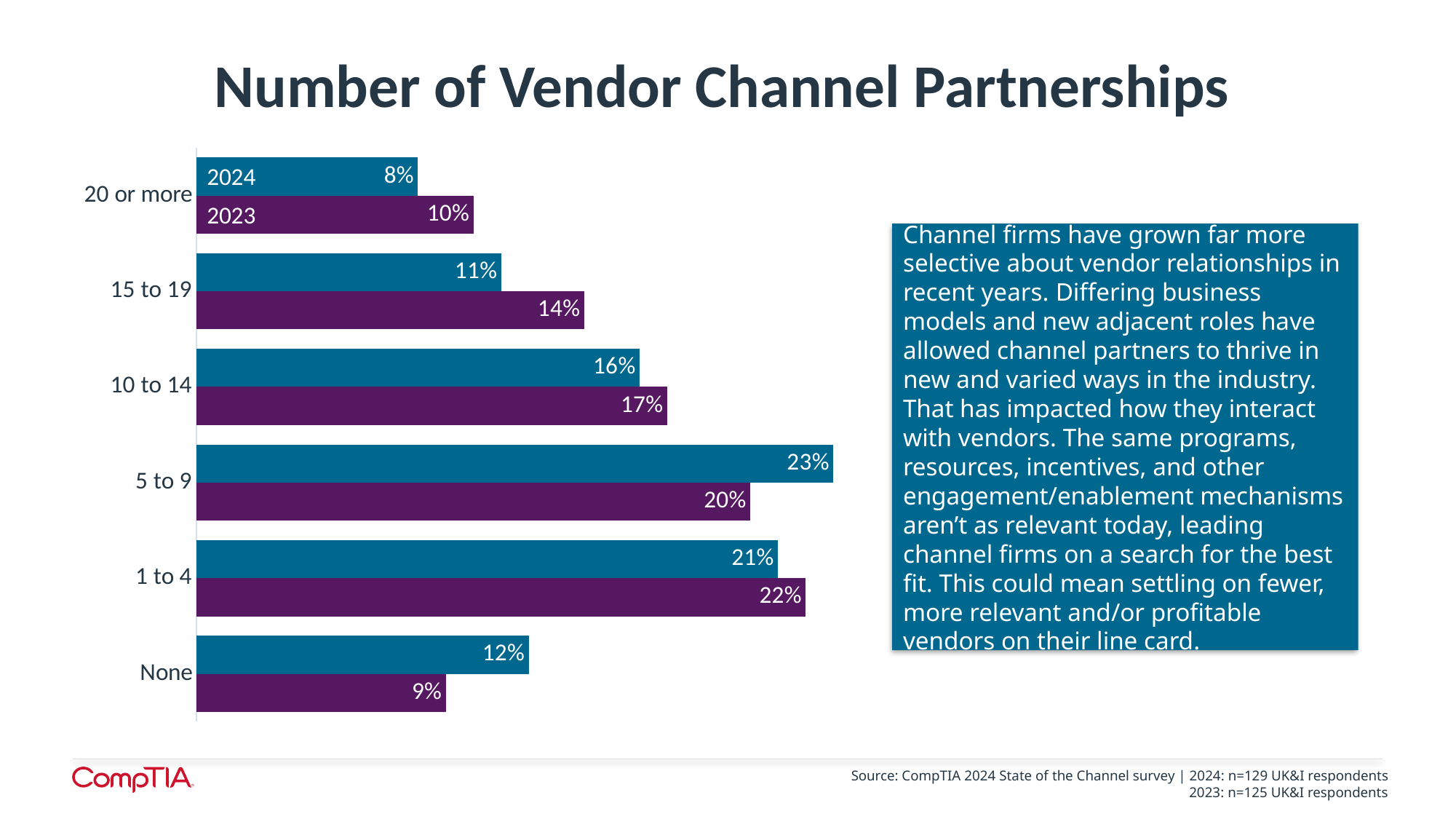
Which category has the lowest 2024 value? 20 or more Which category has the lowest 2023 value? None What is the difference between the 2024 and 2023 values for '5 to 9'? 3% What kind of chart is shown on the slide? Bar chart How many series does the chart show? 2 Which is larger for '1 to 4': the 2024 value or the 2023 value? 2023 What is the 2024 value for '5 to 9' vendor channel partnerships? 23% What is the difference between the 2023 and 2024 values for '15 to 19'? 3% What is the 2023 value for '15 to 19' vendor channel partnerships? 14% How many categories are shown on the chart? 6 What is the 2024 value for 'None'? 12% Which category has the highest 2024 value? 5 to 9